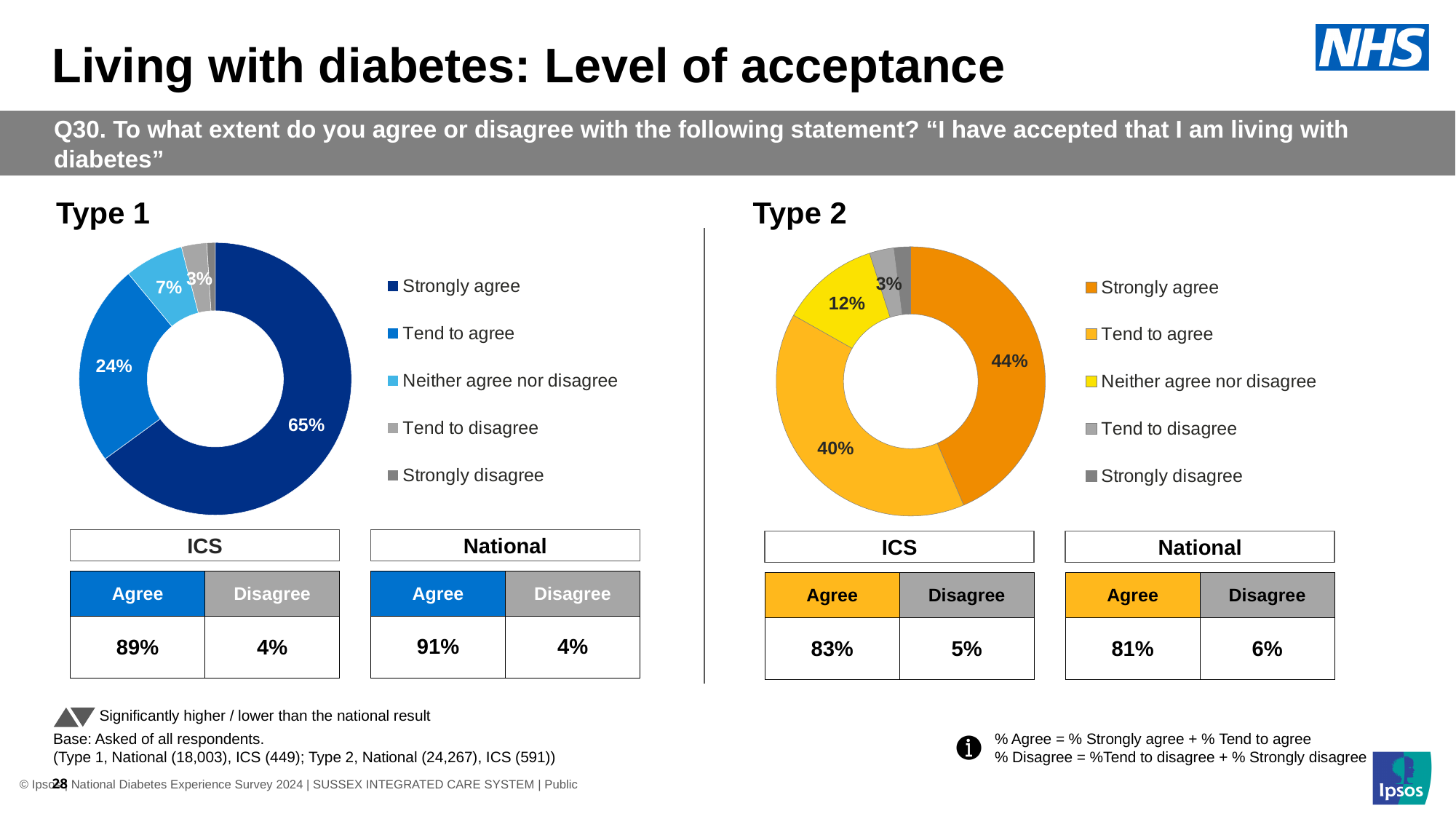
What kind of chart is used for Type 2? Donut chart In the Type 2 chart, what percentage of respondents said they neither agree nor disagree? 12% In the Type 1 chart, what percentage of respondents said they tend to agree? 24% In the Type 2 chart, which response category has the largest share? Strongly agree In the Type 1 chart, what percentage of respondents said they strongly agree? 65% In the Type 1 chart, which response category has the largest share? Strongly agree How many response categories does the legend of the Type 1 chart list? 5 Which is larger: the Neither agree nor disagree share in the Type 1 chart or in the Type 2 chart? Type 2 In the Type 1 chart, what colour represents Strongly agree? Dark blue In the Type 1 chart, what is the difference between the Strongly agree and Tend to agree shares? 41 percentage points In the Type 2 chart, what is the difference between the Strongly agree and Tend to agree shares? 4 percentage points In the Type 2 chart, what percentage of respondents said they strongly agree? 44%